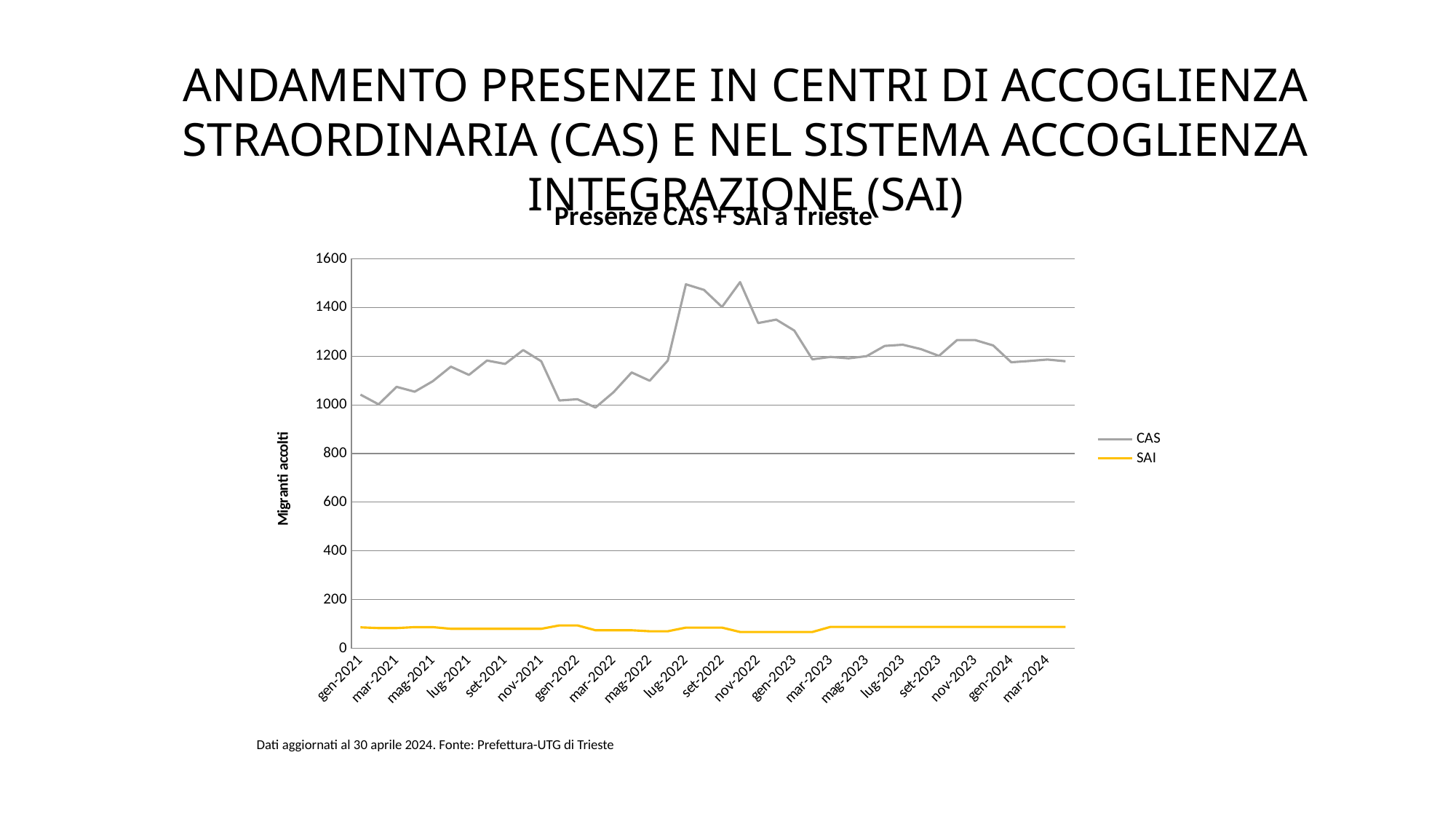
Does the CAS line rise or fall between set-2022 and gen-2023? fall Is the CAS value for nov-2022 greater or less than 1200? greater Is the SAI value for set-2022 greater or less than 200? less What are the two series named in the legend? CAS and SAI What is the title of the chart? Presenze CAS + SAI a Trieste What kind of chart is shown on the slide? line chart Is the SAI value for gen-2021 greater or less than 400? less Does the CAS line rise or fall between gen-2021 and set-2021? rise How many series does the legend list? 2 Which series has the higher values throughout the chart, CAS or SAI? CAS